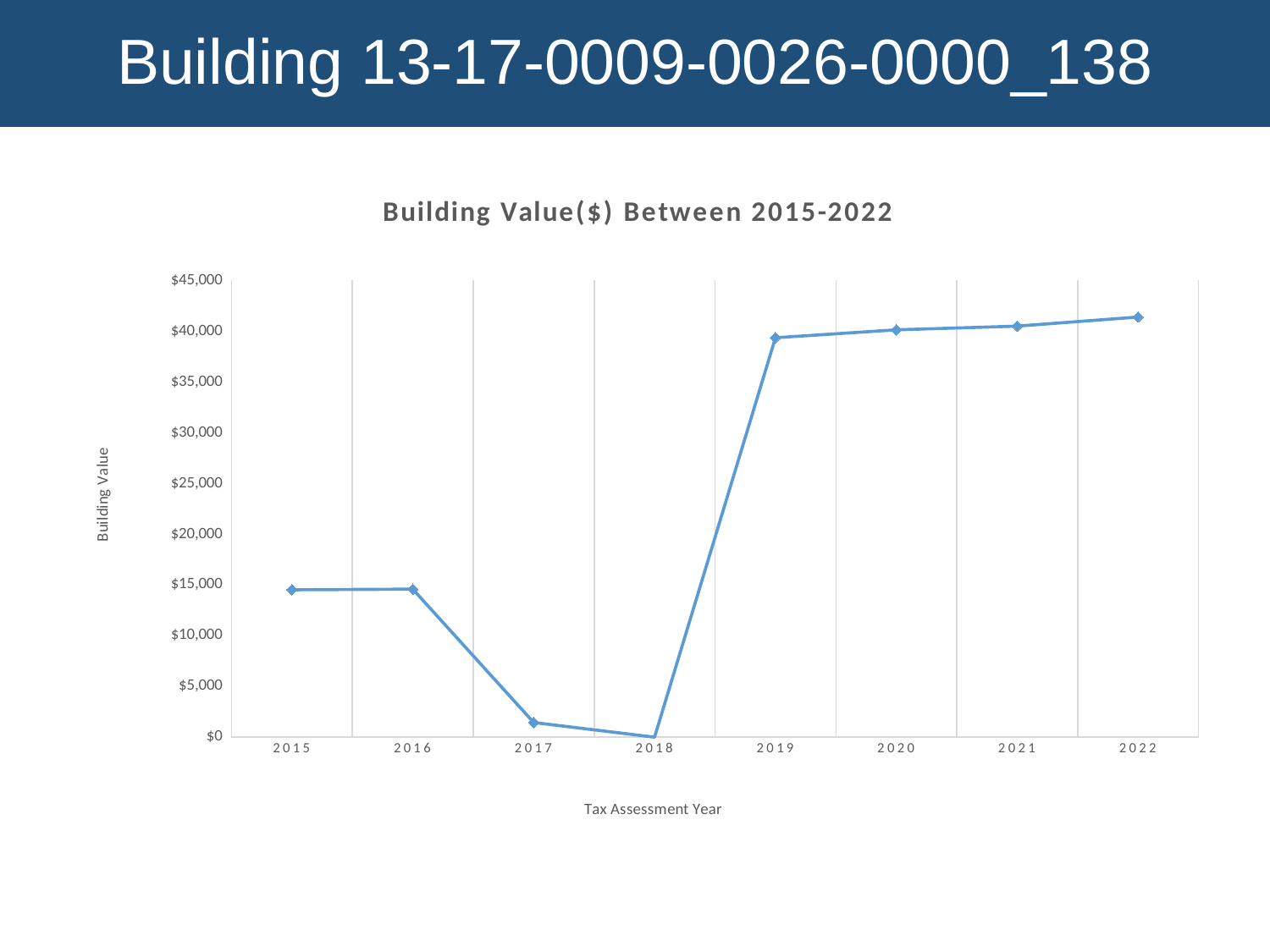
What is the label on the x axis of the chart? Tax Assessment Year What kind of chart is shown on the slide? line chart Is the building value for 2019 greater or less than $35,000? greater Is the building value for 2022 greater or less than $40,000? greater Which year has the lowest building value? 2018 Is the building value for 2017 greater or less than $5,000? less What is the title of the chart? Building Value($) Between 2015-2022 What is the building value in 2018? $0 Does the building value rise or fall between 2016 and 2018? fall How many tax assessment years are plotted on the chart? 8 Which year has the larger building value, 2016 or 2019? 2019